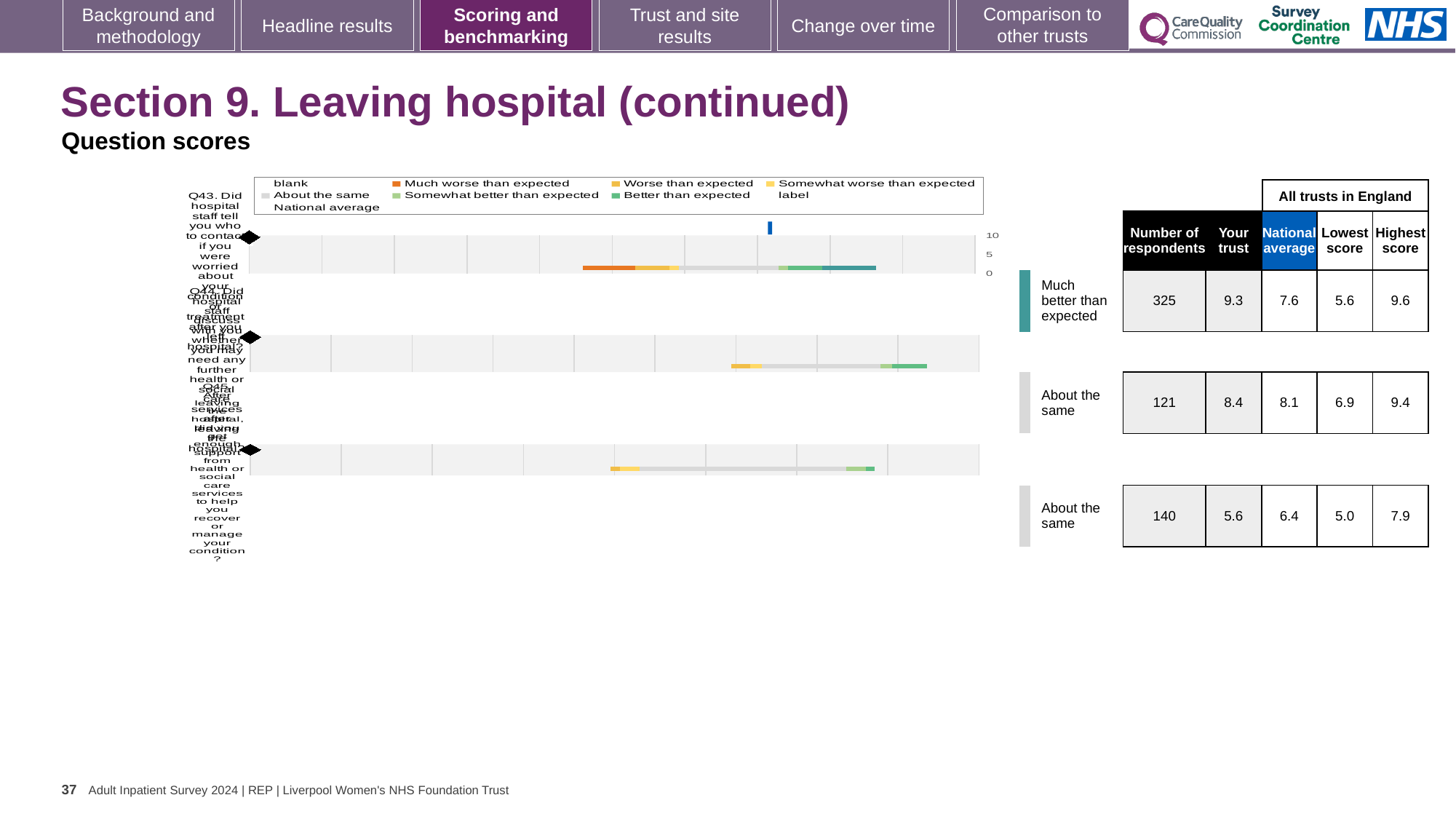
What is the difference between the 'Your trust' score and the national average for the first question (Q43)? 1.7 What is the 'Your trust' score for the third question (Q45)? 5.6 How many questions (Q43, Q44, Q45) are plotted on the slide? 3 What benchmark category is shown for the first question (Q43)? Much better than expected For the third question (Q45), is the 'Your trust' score or the national average larger? National average What is the national average score for the second question (Q44)? 8.1 What kind of chart is used to show the question scores on this slide? bar chart What is the highest score across all trusts in England for the third question (Q45)? 7.9 How many respondents answered the first question (Q43)? 325 Which question has the highest 'Your trust' score? Q43 Which question has the lowest number of respondents? Q44 What is the 'Your trust' score for the first question (Q43)? 9.3